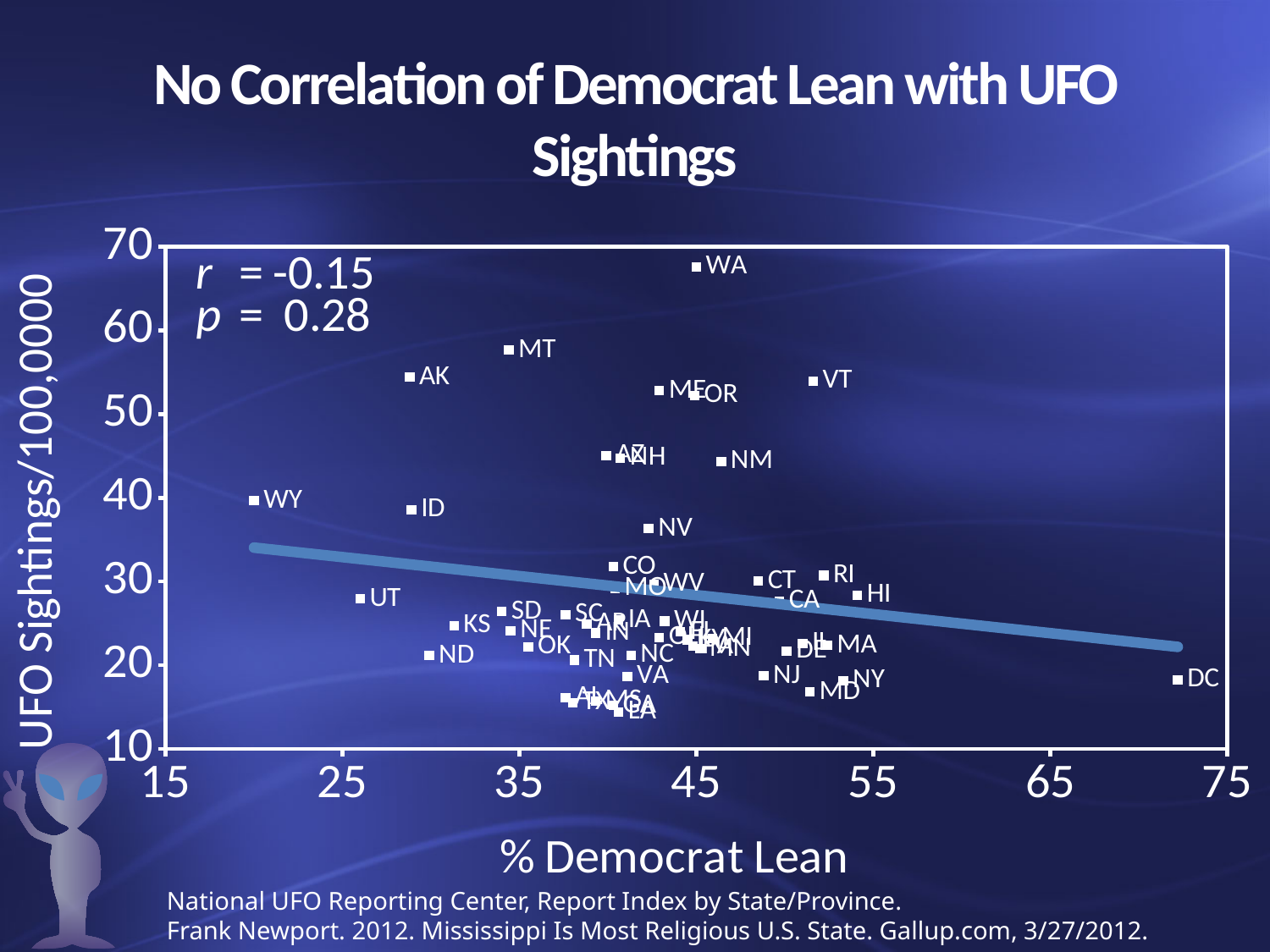
What kind of chart is shown on the slide? scatter chart Is the UFO sightings value for WA greater or less than 60? greater Which state has the highest UFO sightings per 100,000? WA Is the % Democrat lean for DC greater or less than 65? greater Is the UFO sightings value for MT greater or less than 50? greater What correlation coefficient r is printed on the chart? -0.15 Does the fitted trend line rise or fall as % Democrat Lean increases? falls Which has more UFO sightings per 100,000, AK or ID? AK Which state has the highest % Democrat lean? DC Which state has the lowest % Democrat lean? WY